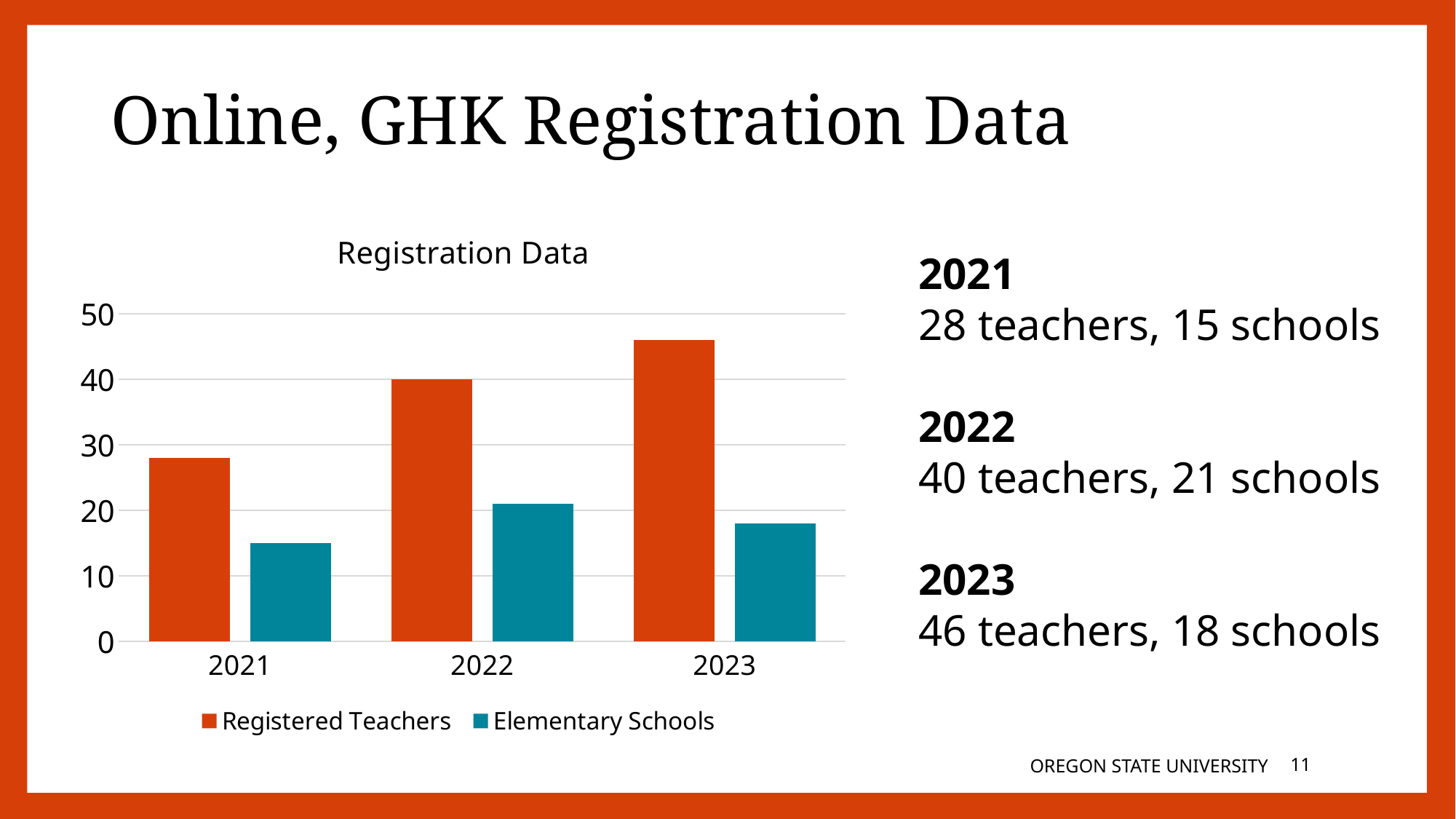
What is the value for Registered Teachers in 2023? 46 What is the difference between Registered Teachers in 2023 and 2021? 18 Do the Registered Teachers values rise or fall from 2021 to 2023? rise What type of chart is shown on the slide? bar chart What is the value for Registered Teachers in 2022? 40 What is the value for Elementary Schools in 2021? 15 Is the value for Registered Teachers in 2021 greater or less than 30? less How many series does the legend of the Registration Data chart list? 2 Which year has the lowest value for Elementary Schools? 2021 Which year has the highest value for Registered Teachers? 2023 How many years are shown on the x axis of the Registration Data chart? 3 Which is larger: Elementary Schools in 2022 or Elementary Schools in 2023? 2022